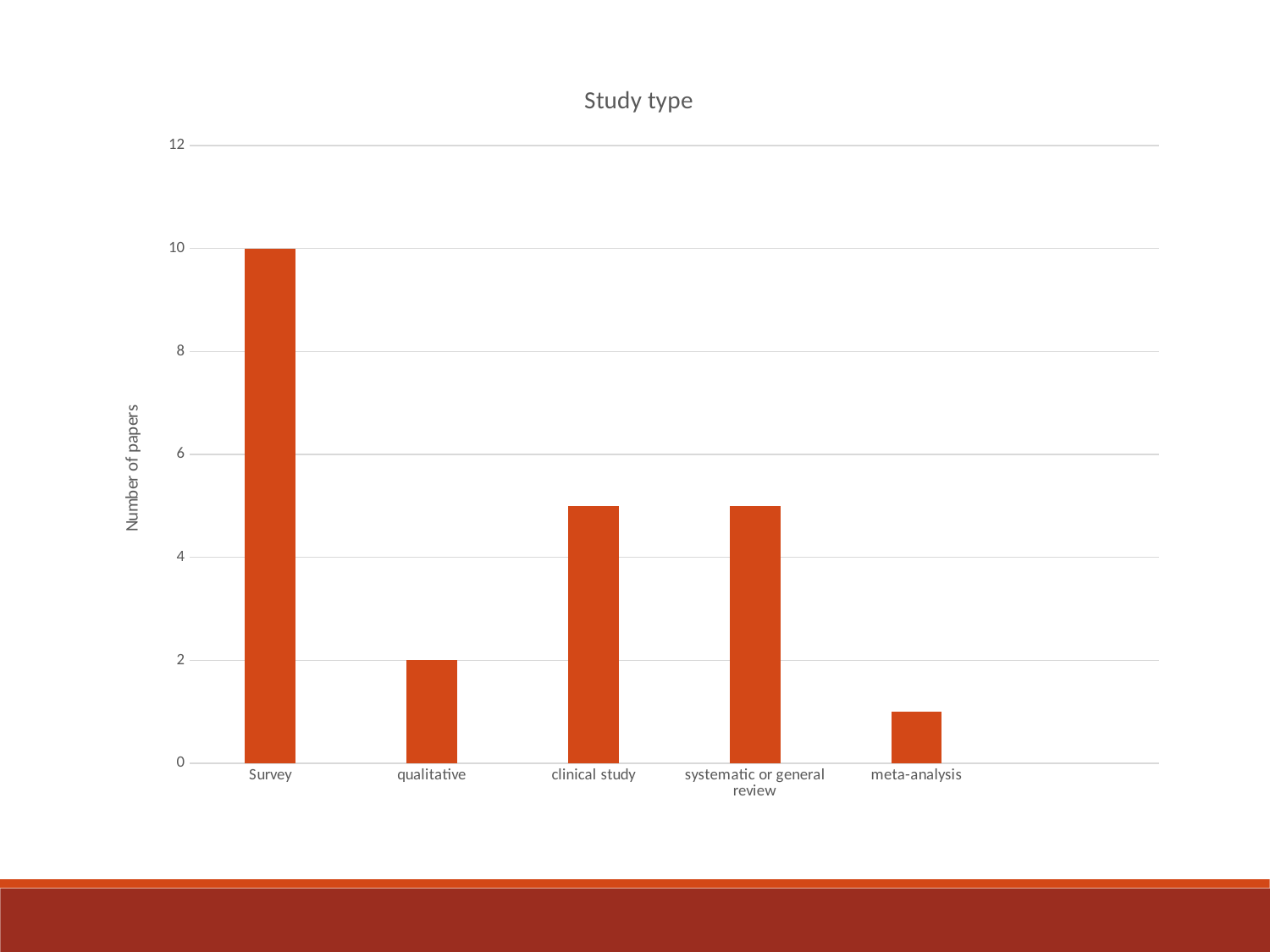
What is the title of the chart? Study type What is the number of papers for Survey? 10 Which study type has the highest number of papers? Survey What is the number of papers for qualitative? 2 What is the difference in number of papers between Survey and qualitative? 8 Which has more papers, clinical study or meta-analysis? clinical study What is the label on the vertical axis? Number of papers How many study type categories are shown on the chart? 5 What type of chart is shown on the slide? bar chart Which study type has the lowest number of papers? meta-analysis Is the value for meta-analysis greater or less than 2? less Is the value for clinical study greater or less than 4? greater